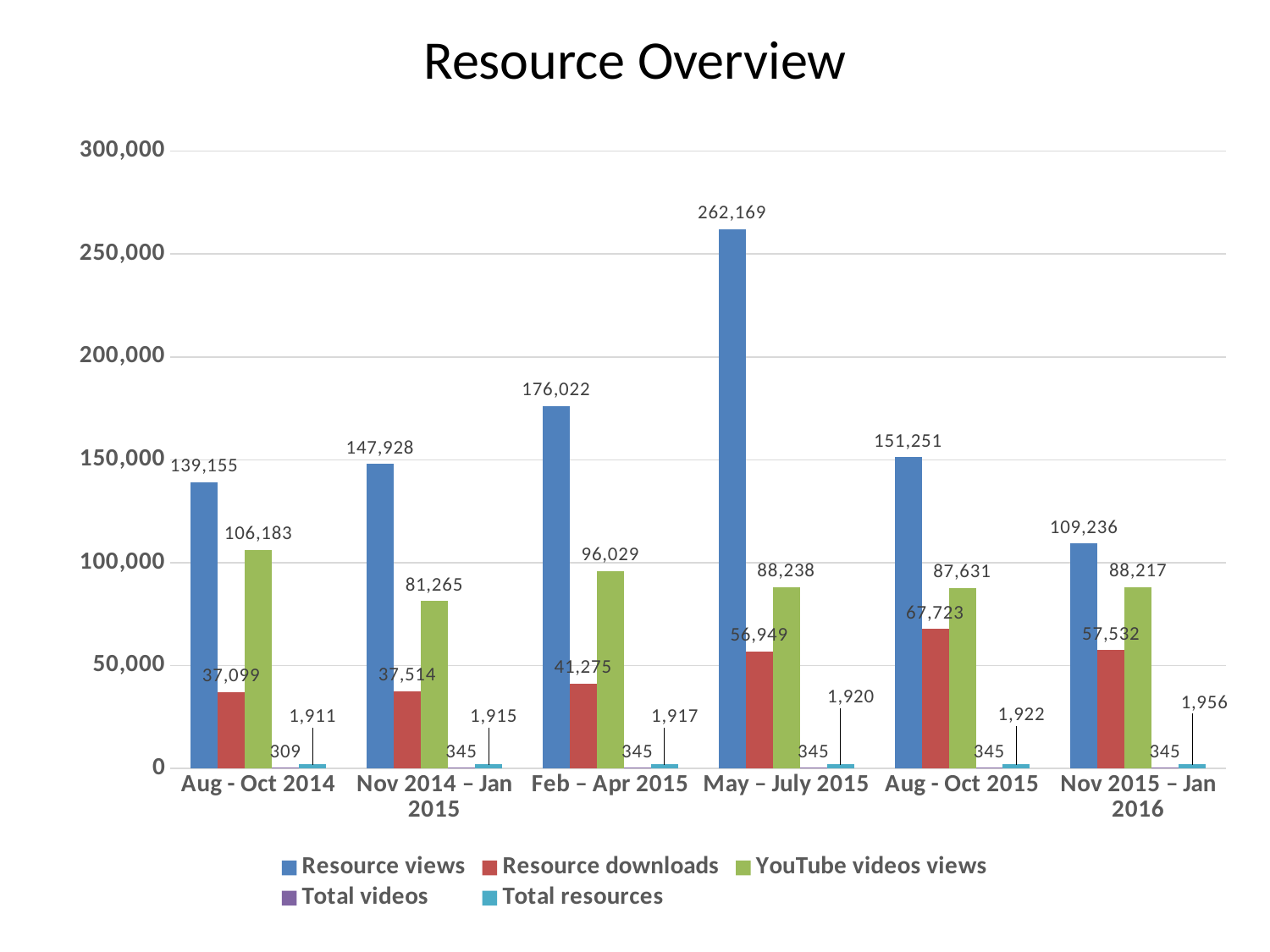
Which period has the larger YouTube videos views: Aug - Oct 2014 or Feb – Apr 2015? Aug - Oct 2014 Which period has the highest Resource downloads? Aug - Oct 2015 What is the value of Resource views for May – July 2015? 262,169 What is the difference in Resource views between May – July 2015 and Feb – Apr 2015? 86,147 Do the Total resources values rise or fall from Aug - Oct 2014 to Nov 2015 – Jan 2016? Rise How many series does the legend list? 5 What kind of chart is shown on the slide? Bar chart What is the value of Resource downloads for Aug - Oct 2015? 67,723 Which period has the lowest Resource views? Nov 2015 – Jan 2016 How many time periods are shown on the x axis? 6 Which period has the highest Resource views? May – July 2015 Is the value of Resource views for Feb – Apr 2015 greater or less than 150,000? greater